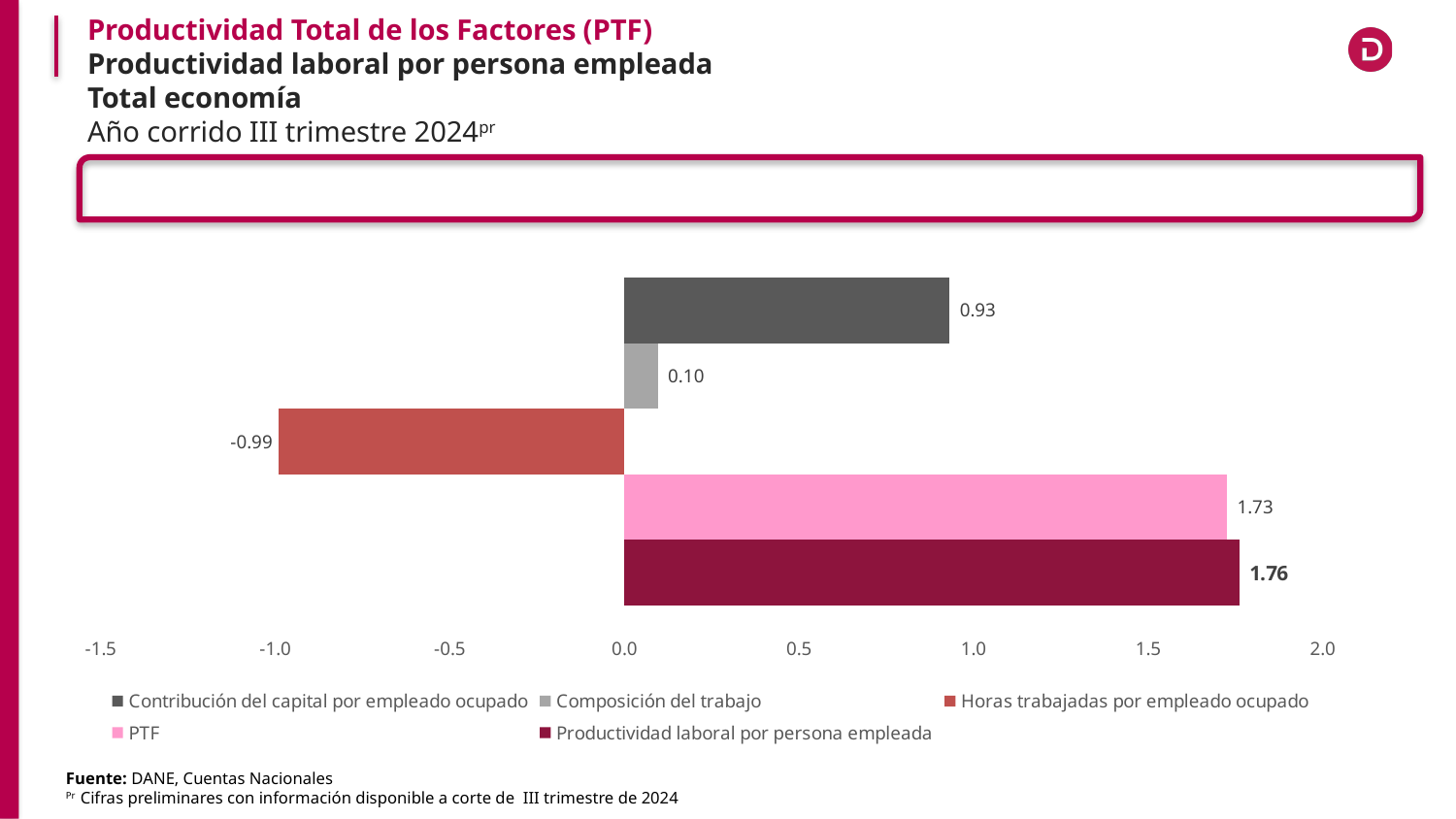
Which is larger, the value for PTF or the value for Contribución del capital por empleado ocupado? PTF What is the value for PTF? 1.73 What is the value for Productividad laboral por persona empleada? 1.76 What kind of chart is shown on the slide? Bar chart What is the value for Horas trabajadas por empleado ocupado? -0.99 What is the difference between the value for Contribución del capital por empleado ocupado and the value for Composición del trabajo? 0.83 Which series has the lowest value? Horas trabajadas por empleado ocupado Which series has the highest value? Productividad laboral por persona empleada What is the source cited for the chart? DANE, Cuentas Nacionales What is the value for Contribución del capital por empleado ocupado? 0.93 How many series does the legend list? 5 What is the value for Composición del trabajo? 0.10